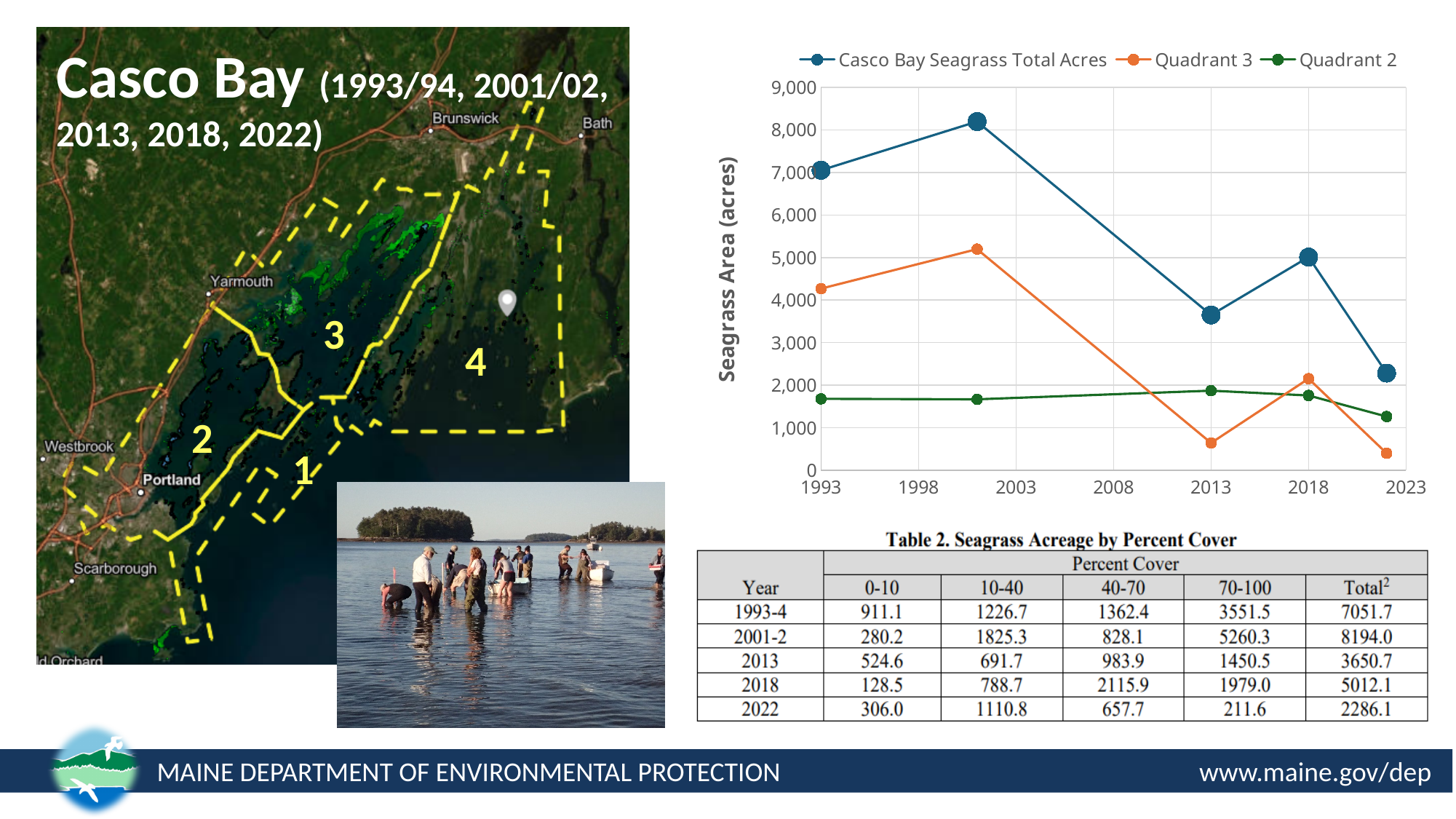
What kind of chart is shown on the right of the slide? line chart How many series does the legend of the seagrass chart list? 3 In 2013, which is larger: the Quadrant 2 value or the Quadrant 3 value? Quadrant 2 Does the Casco Bay Seagrass Total Acres series rise or fall between 2018 and its last point? fall How many data points are plotted for the Casco Bay Seagrass Total Acres series? 5 Is the Quadrant 3 value for 2013 greater or less than 1,000? less Which series has the lowest value in 2013 on the seagrass chart? Quadrant 3 Is the Casco Bay Seagrass Total Acres value for 1993 greater or less than 6,000? greater Is the Casco Bay Seagrass Total Acres value for 2018 greater or less than 4,000? greater Which series has the highest value in 2018 on the seagrass chart? Casco Bay Seagrass Total Acres What is the title of the y axis on the seagrass chart? Seagrass Area (acres)